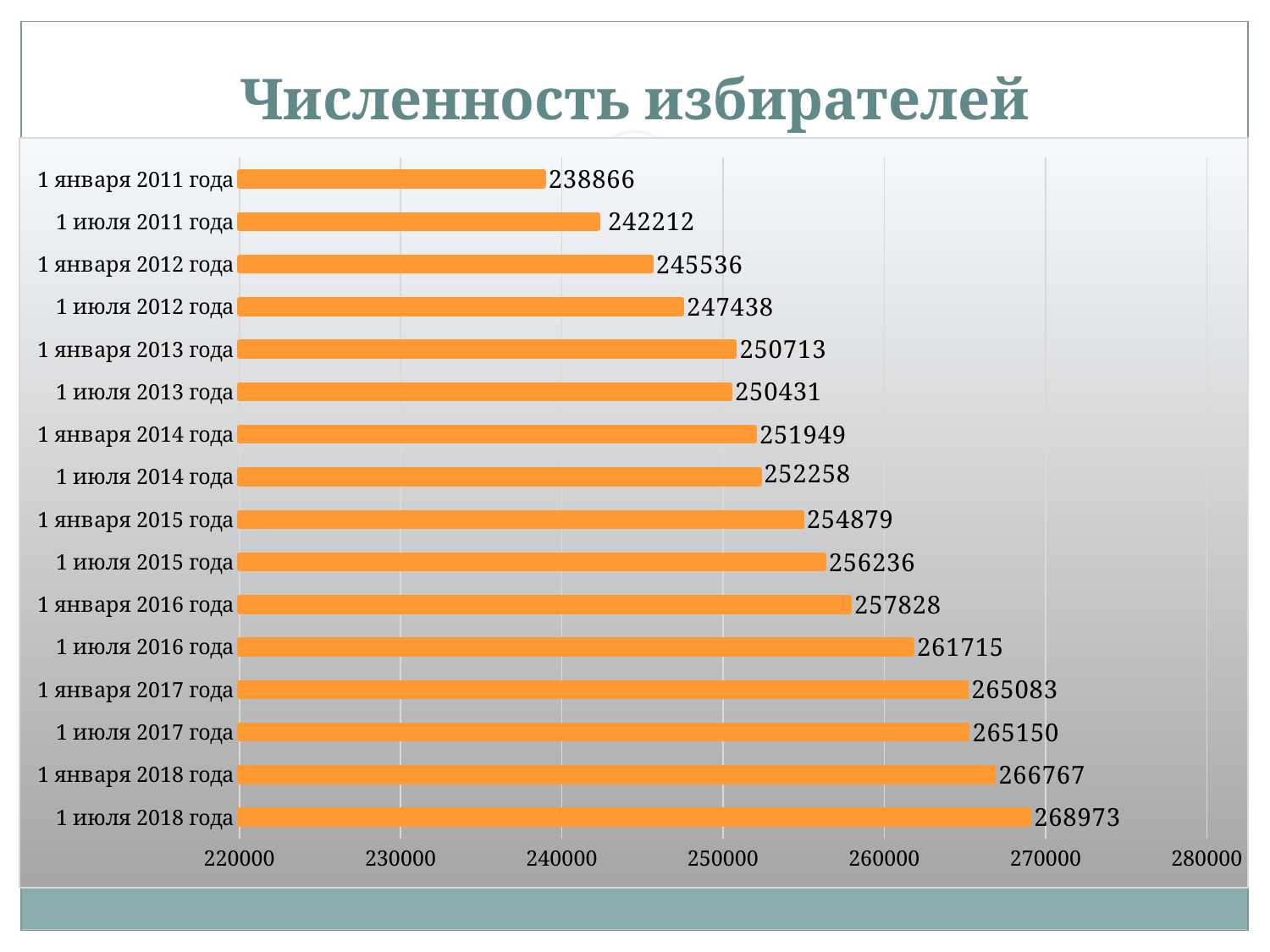
Is the number of voters on 1 июля 2012 года greater or less than 250000? less What kind of chart is shown on the slide? bar chart What is the number of voters on 1 июля 2016 года? 261715 What is the difference between the number of voters on 1 июля 2016 года and on 1 января 2016 года? 3887 Which date has the highest number of voters? 1 июля 2018 года What is the title of the chart? Численность избирателей What is the difference between the number of voters on 1 июля 2018 года and on 1 января 2011 года? 30107 Which date has the lowest number of voters? 1 января 2011 года Which is larger: the number of voters on 1 января 2013 года or on 1 июля 2013 года? 1 января 2013 года What is the number of voters on 1 января 2015 года? 254879 How many dates are shown on the chart? 16 What is the number of voters on 1 января 2011 года? 238866